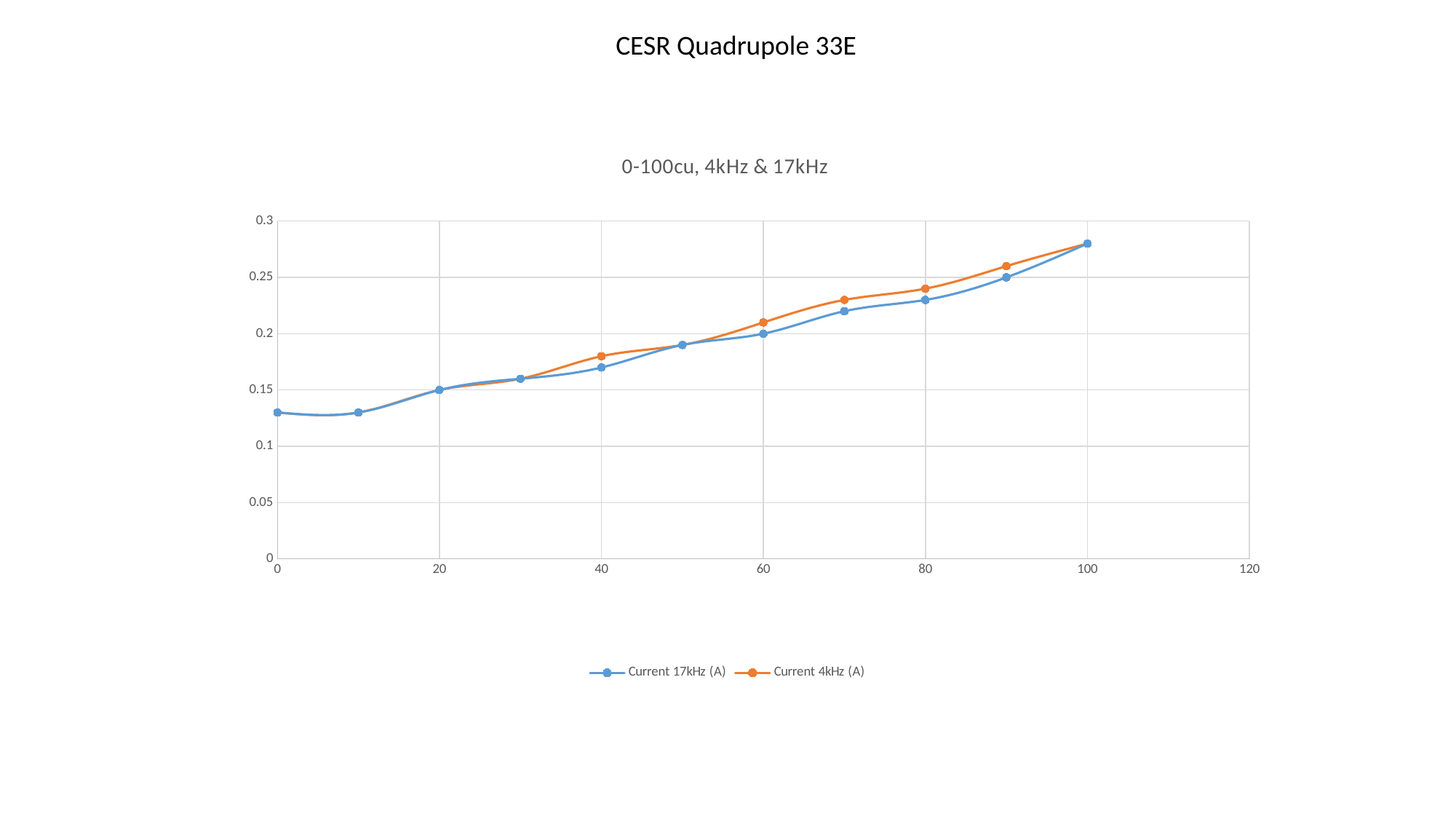
How many data points does the Current 17kHz (A) series have? 11 Is the value of Current 4kHz (A) at x = 100 greater or less than 0.25? greater What kind of chart is shown on the slide? line chart Do the values of the Current 4kHz (A) series generally rise or fall as the x axis increases? rise How many series does the legend list? 2 What is the subtitle shown above the chart's plot area? 0-100cu, 4kHz & 17kHz Is the value of Current 17kHz (A) at x = 0 greater or less than 0.15? less At which x value does the Current 17kHz (A) series reach its highest value? 100 Which series is drawn in orange? Current 4kHz (A) Is the value of Current 17kHz (A) at x = 80 greater or less than 0.2? greater At x = 90, which series has the larger value, Current 17kHz (A) or Current 4kHz (A)? Current 4kHz (A)